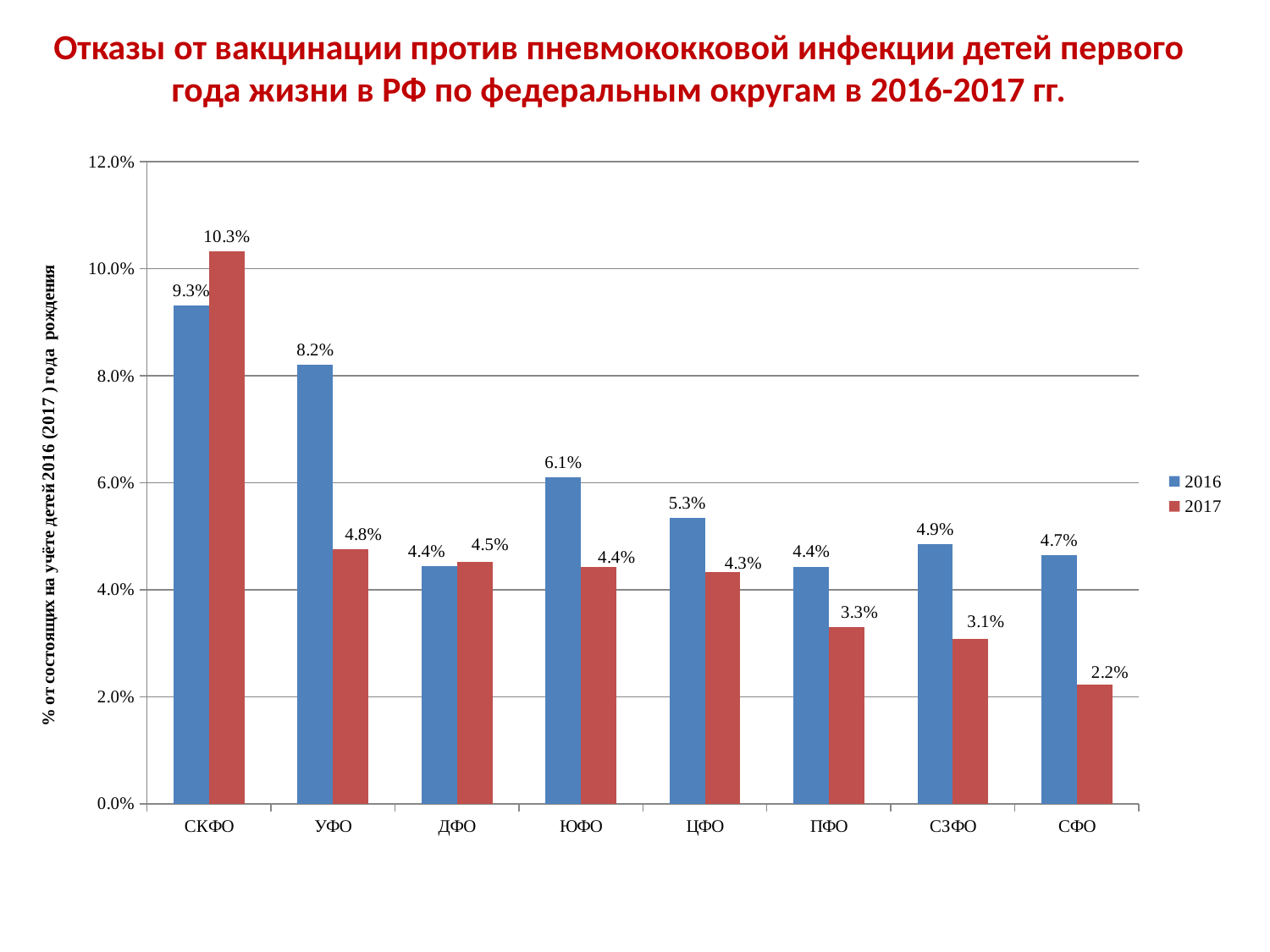
What is the value for СКФО in the 2017 series? 10.3% What is the difference between the 2016 and 2017 values for УФО? 3.4% What kind of chart is shown on the slide? bar chart Which colour represents the 2017 series in the legend? red What is the value for УФО in the 2016 series? 8.2% Which is larger for ЮФО: the 2016 value or the 2017 value? 2016 How many federal districts are shown on the x axis? 8 What is the value for СФО in the 2017 series? 2.2% Which federal district has the highest value in the 2016 series? СКФО Which federal district has the lowest value in the 2017 series? СФО Is the 2016 value for ЦФО greater or less than 4.0%? greater How many series does the legend list? 2